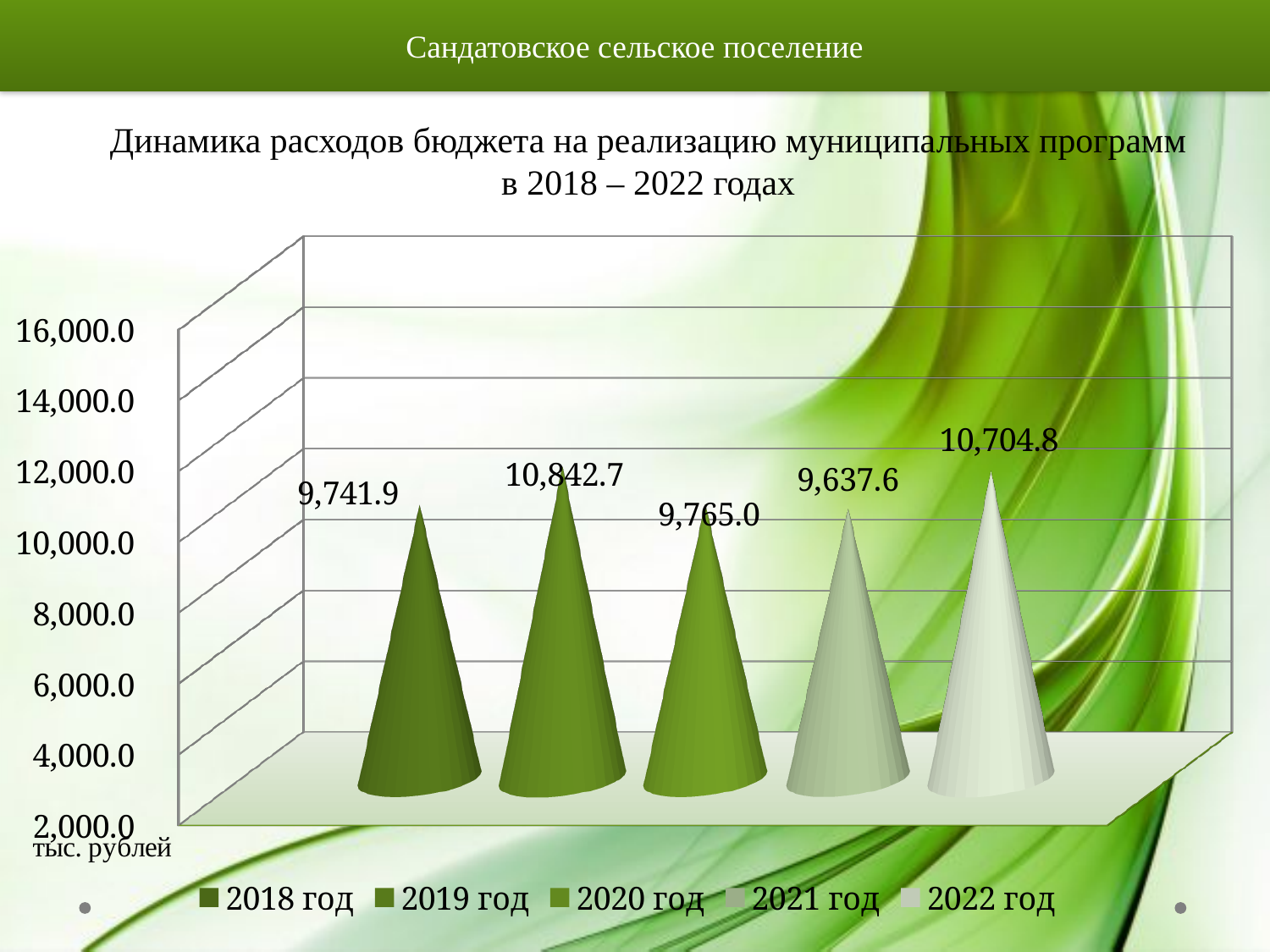
What is the difference between the values for 2019 год and 2018 год? 1,100.8 What unit is shown below the vertical axis of the chart? тыс. рублей Which year has the lowest value? 2021 год What is the value for 2022 год? 10,704.8 How many years are plotted on the chart? 5 Is the value for 2021 год greater or less than 8,000.0? greater How many series does the legend list? 5 Which is larger, the value for 2019 год or the value for 2022 год? 2019 год What is the difference between the values for 2022 год and 2021 год? 1,067.2 Which year has the highest value? 2019 год What is the value for 2020 год? 9,765.0 What is the value for 2018 год? 9,741.9